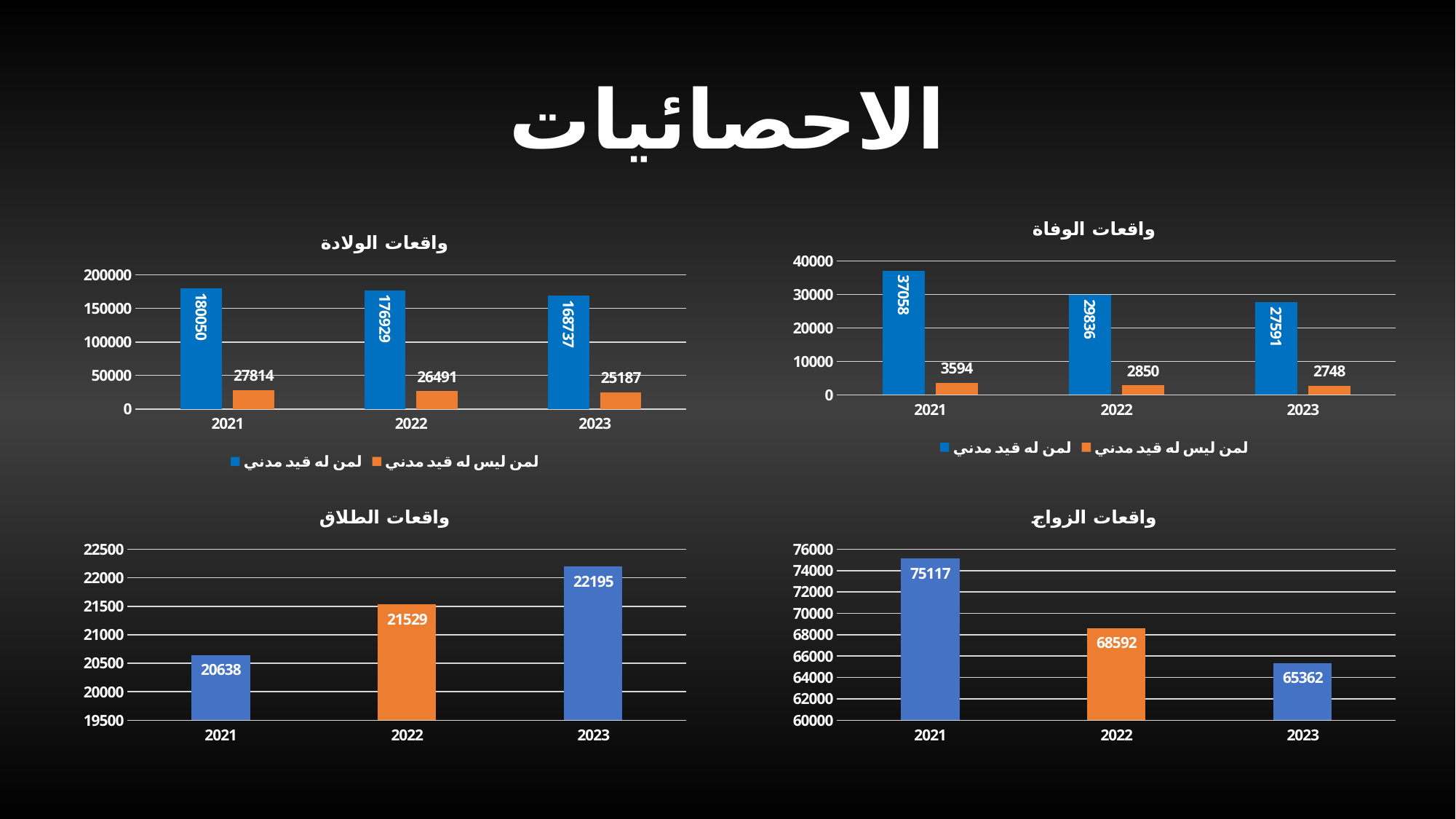
In the واقعات الطلاق chart, do the values rise or fall from 2021 to 2023? rise What kind of chart is the واقعات الطلاق chart? bar chart In the واقعات الولادة chart, what is the difference between the لمن له قيد مدني values for 2021 and 2023? 11313 In the واقعات الزواج chart, which year has the highest value? 2021 In the واقعات الزواج chart, how many years are shown on the x axis? 3 In the واقعات الولادة chart, what is the value for لمن ليس له قيد مدني in 2023? 25187 In the واقعات الوفاة chart, which year has the lowest value for لمن ليس له قيد مدني? 2023 In the واقعات الوفاة chart, what is the value for لمن له قيد مدني in 2022? 29836 In the واقعات الوفاة chart, how many series does the legend list? 2 In the واقعات الولادة chart, what is the value for لمن له قيد مدني in 2021? 180050 In the واقعات الطلاق chart, what is the value for 2022? 21529 In the واقعات الزواج chart, what is the difference between the values for 2021 and 2023? 9755